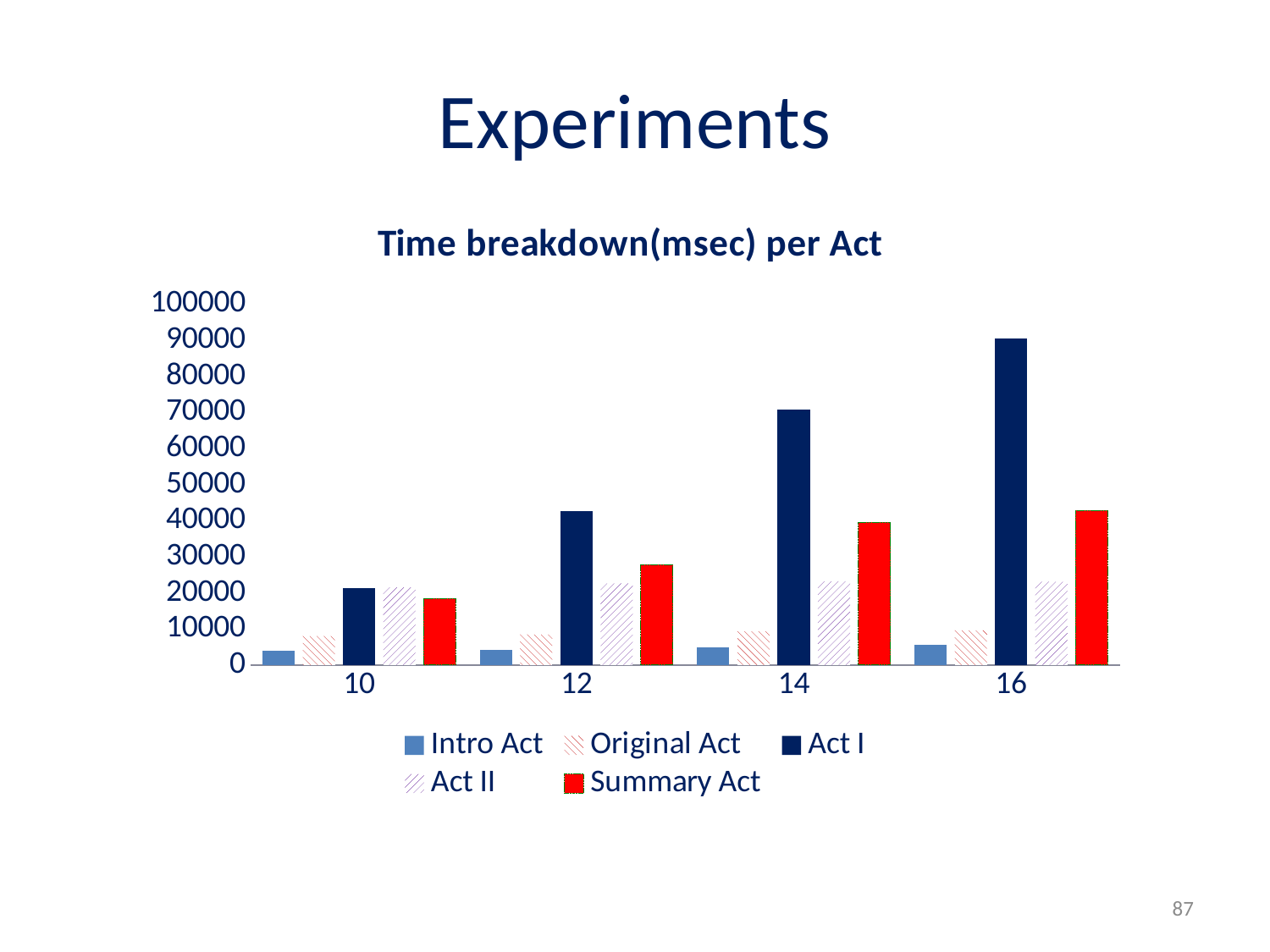
Which series has the lowest value at category 12? Intro Act For which category is the Act I value highest? 16 What is the title of the chart? Time breakdown(msec) per Act At category 14, which is larger: Act I or Summary Act? Act I How many series does the legend list? 5 Do the Act I values rise or fall as the x axis goes from 10 to 16? rise What kind of chart is shown on the slide? bar chart Is the value for Act I at category 12 greater or less than 30000? greater Is the value for Summary Act at category 10 greater or less than 20000? less How many categories are shown on the x axis? 4 Is the value for Summary Act at category 16 greater or less than 50000? less